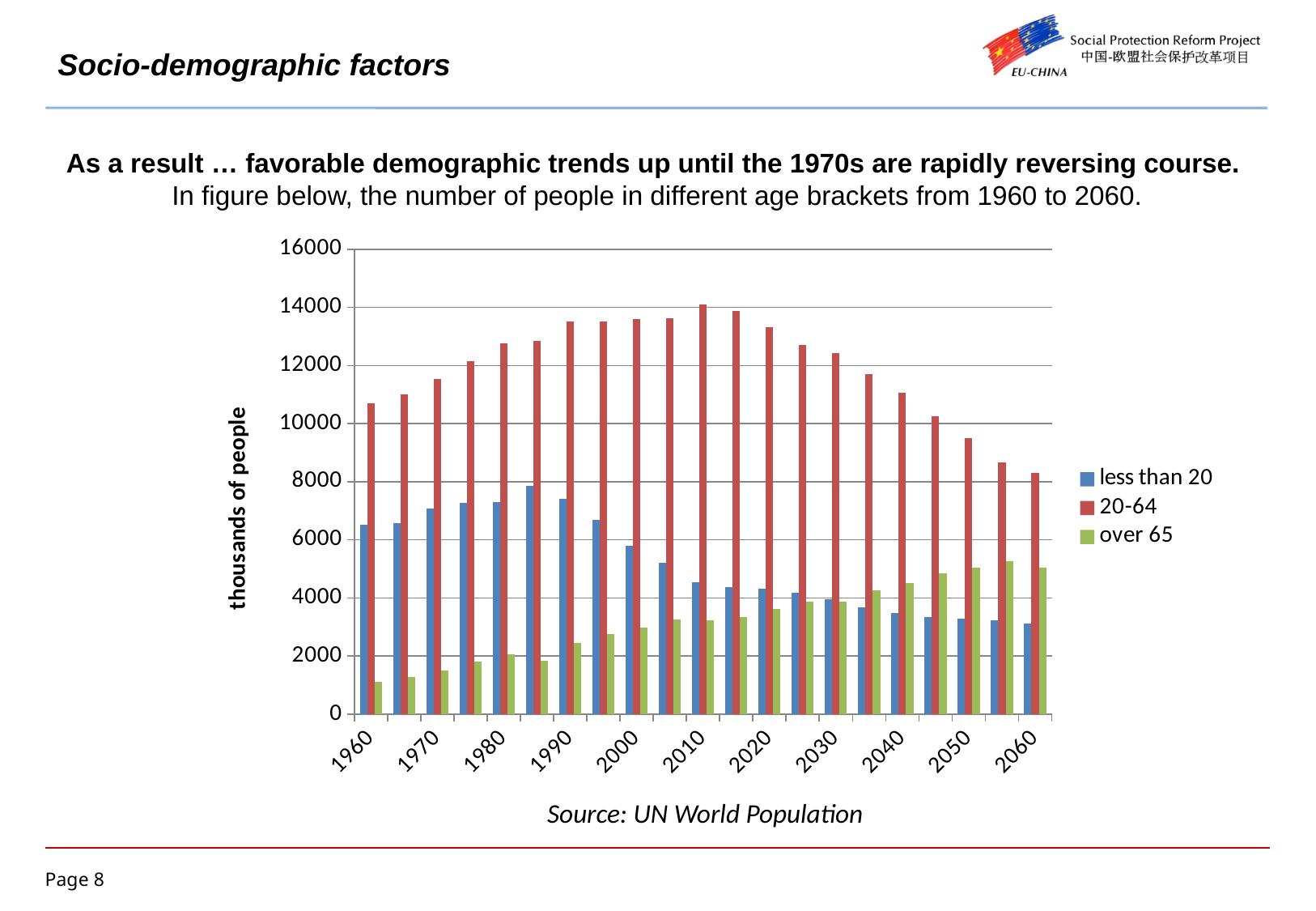
In 2060, which is larger: the less than 20 series or the over 65 series? over 65 Is the value for the less than 20 series in 2060 greater or less than 4000? less Is the value for the 20-64 series in 2050 greater or less than 10000? less In which labeled year is the 20-64 series at its highest? 2010 Is the value for the 20-64 series in 1960 greater or less than 10000? greater What kind of chart is shown on the slide? bar chart What are the three series named in the legend? less than 20, 20-64, over 65 Does the over 65 series rise or fall from 1960 to 2060? rise How many series does the legend list? 3 What is the label on the vertical axis? thousands of people In which year is the over 65 series at its lowest? 1960